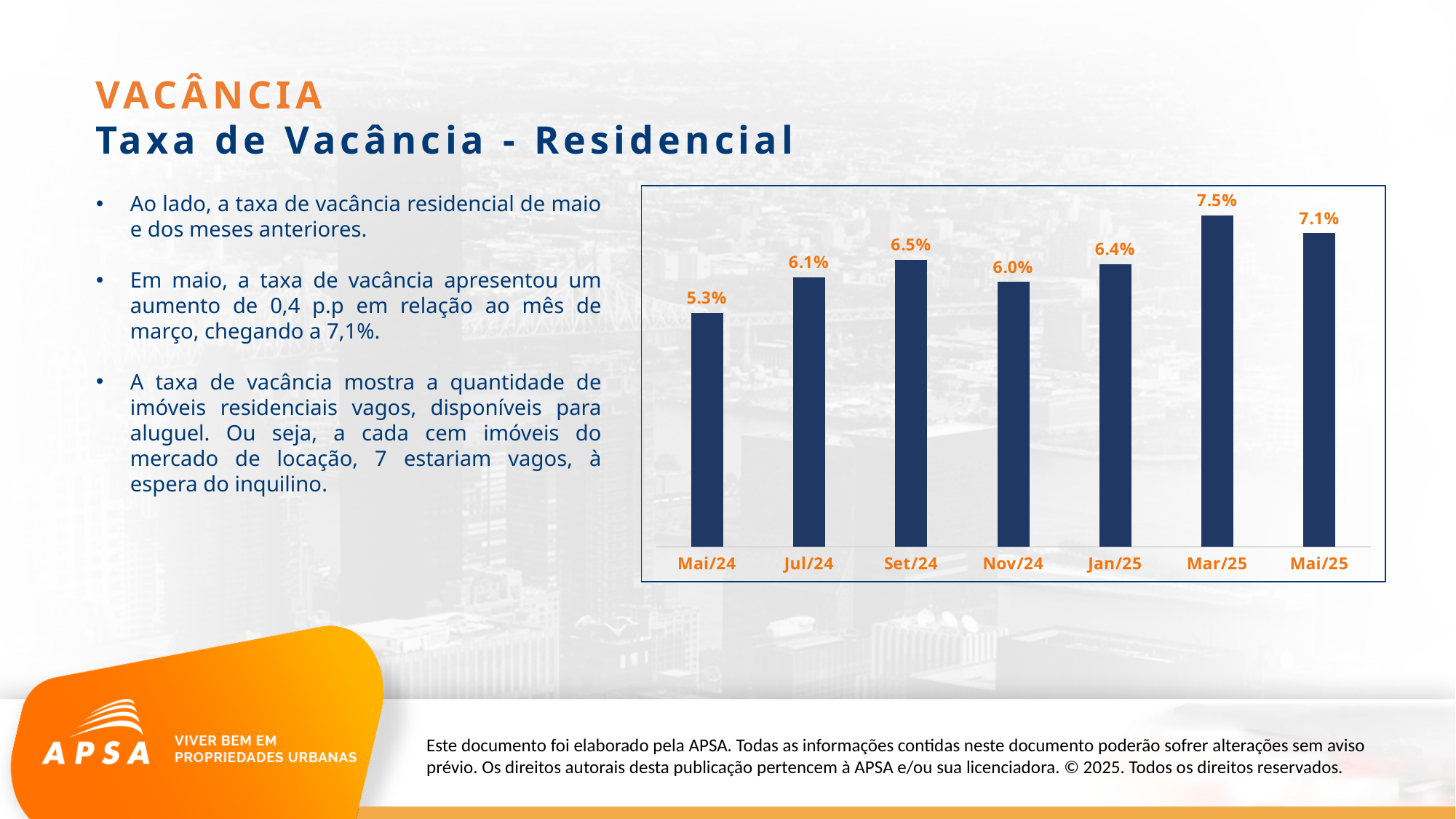
Which is larger, the vacancy rate for Set/24 or for Jan/25? Set/24 Which month has the highest vacancy rate in the chart? Mar/25 What is the vacancy rate shown for Mai/25? 7.1% Does the vacancy rate rise or fall from Mai/24 to Mar/25? Rise Which month has the lowest vacancy rate in the chart? Mai/24 What is the difference in percentage points between the vacancy rate for Mai/25 and Mai/24? 1.8 What kind of chart is shown on the slide? Bar chart How many months are shown on the x axis of the chart? 7 What is the difference in percentage points between the vacancy rate for Mar/25 and Mai/25? 0.4 What is the vacancy rate shown for Mai/24? 5.3% What is the vacancy rate shown for Nov/24? 6.0% Which is larger, the vacancy rate for Jul/24 or for Nov/24? Jul/24